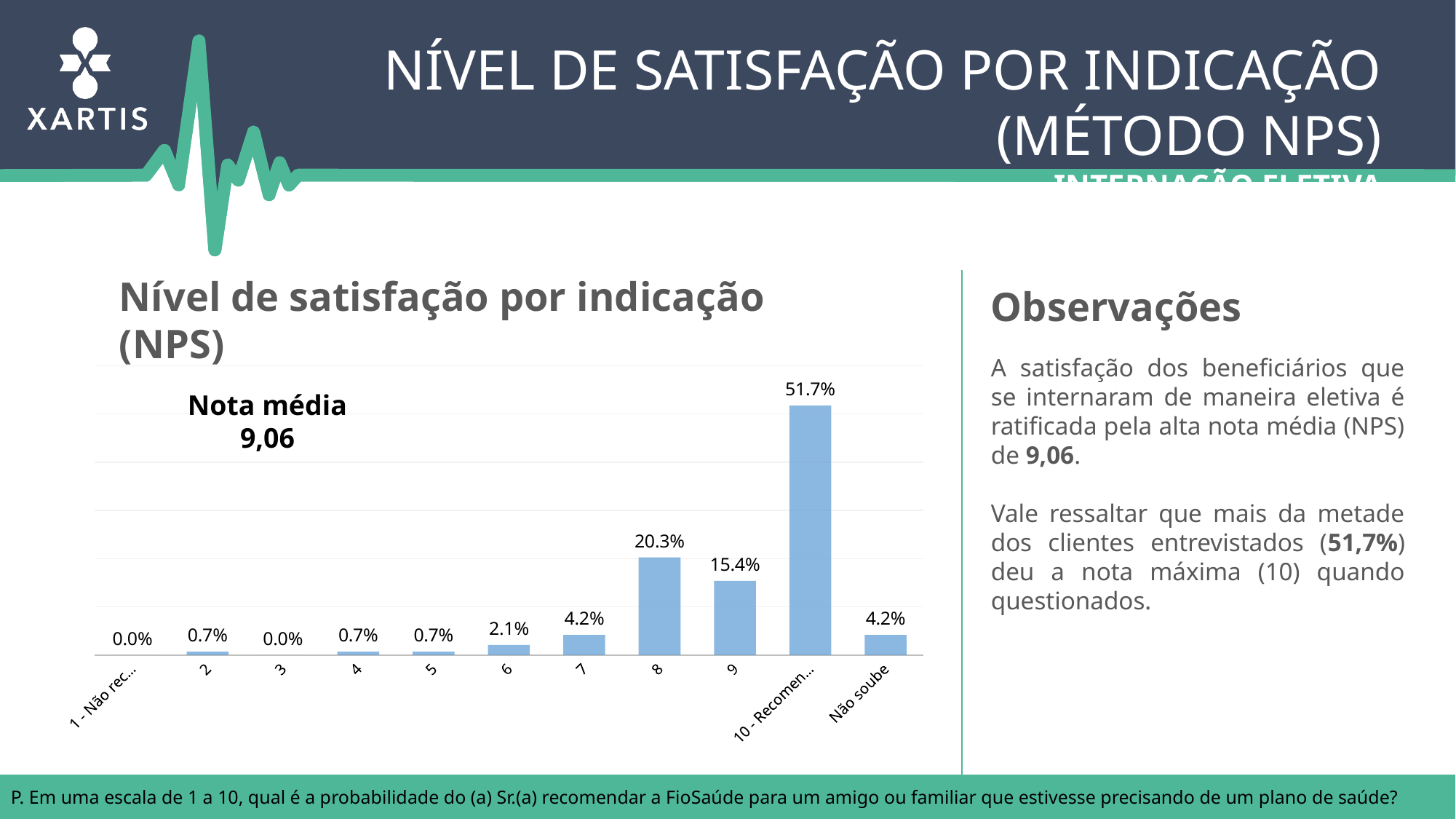
What is the value for category 8? 20.3% What average score (Nota média) is shown on the chart? 9,06 What is the value for category 6? 2.1% What is the value for the 'Não soube' category? 4.2% What is the difference between the values for category 8 and category 9? 4.9% What is the value for category 7? 4.2% Which is larger, the value for category 8 or the value for category 9? category 8 What is the title of the chart? Nível de satisfação por indicação (NPS) Which category has the highest value? 10 - Recomen... What type of chart is shown on the slide? bar chart How many categories are shown on the x axis? 11 What is the value for category 9? 15.4%